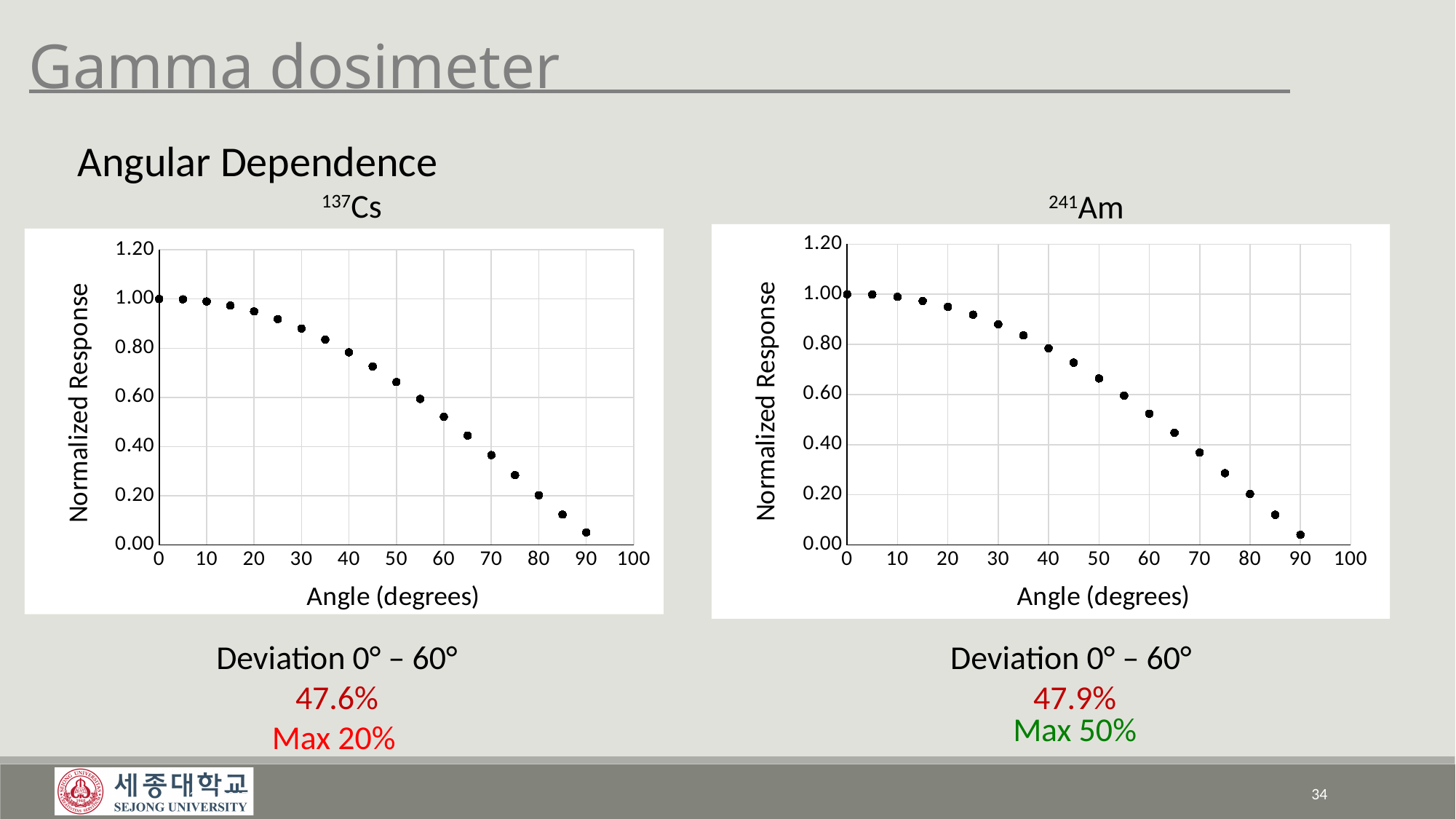
In the 241Am chart, does the normalized response rise or fall as the angle increases? fall What is the x-axis label of the 137Cs chart? Angle (degrees) In the 137Cs chart, does the normalized response rise or fall as the angle increases? fall In the 241Am chart, which angle has the highest normalized response? 0 What kind of chart is the 137Cs chart on the left? scatter chart In the 241Am chart, is the normalized response larger at 20 degrees or at 70 degrees? 20 degrees In the 241Am chart, how many data points are plotted? 19 In the 137Cs chart, which angle has the lowest normalized response? 90 In the 137Cs chart, how many data points are plotted? 19 In the 137Cs chart, is the normalized response at 60 degrees greater or less than 0.60? less In the 137Cs chart, is the normalized response at 90 degrees greater or less than 0.20? less In the 241Am chart, is the normalized response at 30 degrees greater or less than 0.80? greater